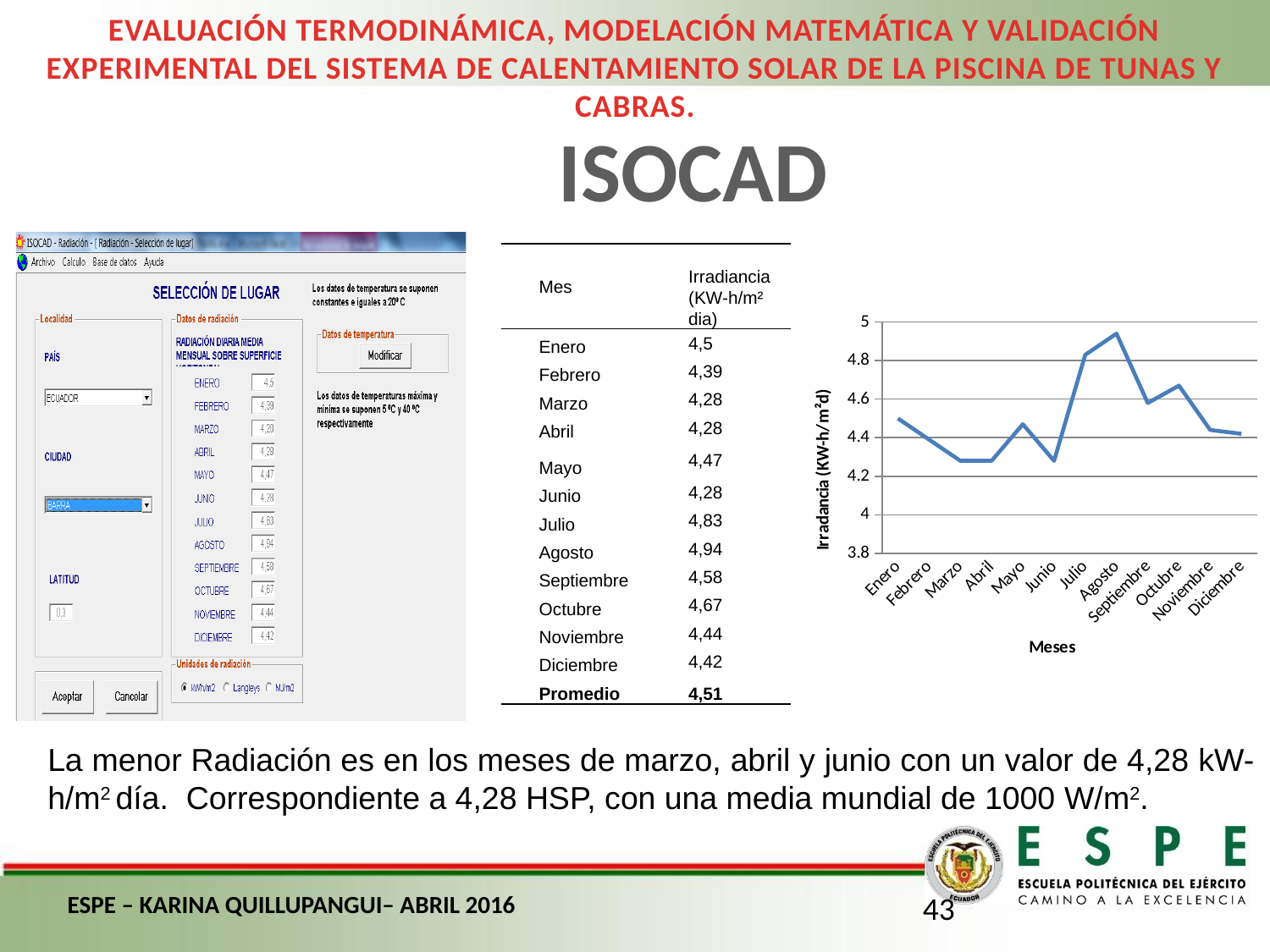
Which month has the larger irradiance value, Julio or Septiembre? Julio Does the line rise or fall from Junio to Agosto? rise What is the irradiance value for Enero, as printed in the table? 4,5 In the line chart, is the value for Agosto greater or less than 4.8? greater How many months are plotted along the x axis of the line chart? 12 What is the label on the x axis of the line chart? Meses In the line chart, is the value for Marzo greater or less than 4.4? less What is the difference between the irradiance values for Agosto and Marzo? 0,66 What is the irradiance value for Agosto, as printed in the table? 4,94 What kind of chart is shown on the right of the slide? line chart Which months share the lowest irradiance value in the chart? Marzo, Abril y Junio Which month has the highest irradiance value in the line chart? Agosto